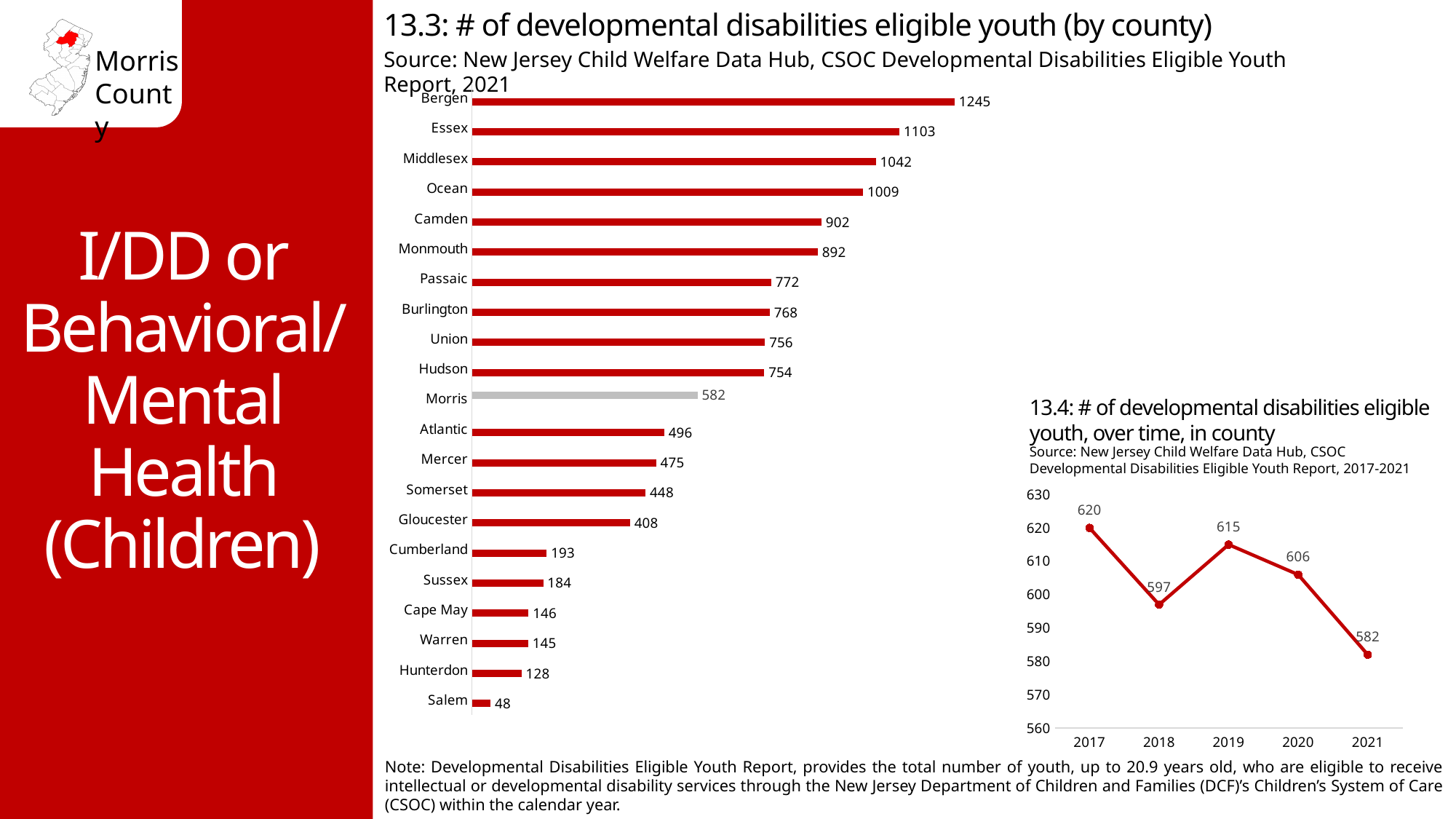
In chart 13.4 (# of developmental disabilities eligible youth over time in county), what is the value for 2019? 615 In chart 13.3 (# of developmental disabilities eligible youth by county), how many counties are shown? 21 In chart 13.3 (# of developmental disabilities eligible youth by county), what is the value for Morris? 582 What kind of chart is chart 13.3 (# of developmental disabilities eligible youth by county)? Bar chart In chart 13.3 (# of developmental disabilities eligible youth by county), what is the value for Hunterdon? 128 What kind of chart is chart 13.4 (# of developmental disabilities eligible youth over time in county)? Line chart In chart 13.3 (# of developmental disabilities eligible youth by county), which county has the lowest value? Salem In chart 13.3 (# of developmental disabilities eligible youth by county), which county has the highest value? Bergen In chart 13.4 (# of developmental disabilities eligible youth over time in county), what is the difference between 2017 and 2021? 38 In chart 13.3 (# of developmental disabilities eligible youth by county), which is larger, Camden or Monmouth? Camden In chart 13.4 (# of developmental disabilities eligible youth over time in county), which year has the lowest value? 2021 In chart 13.3 (# of developmental disabilities eligible youth by county), what is the difference between Bergen and Essex? 142